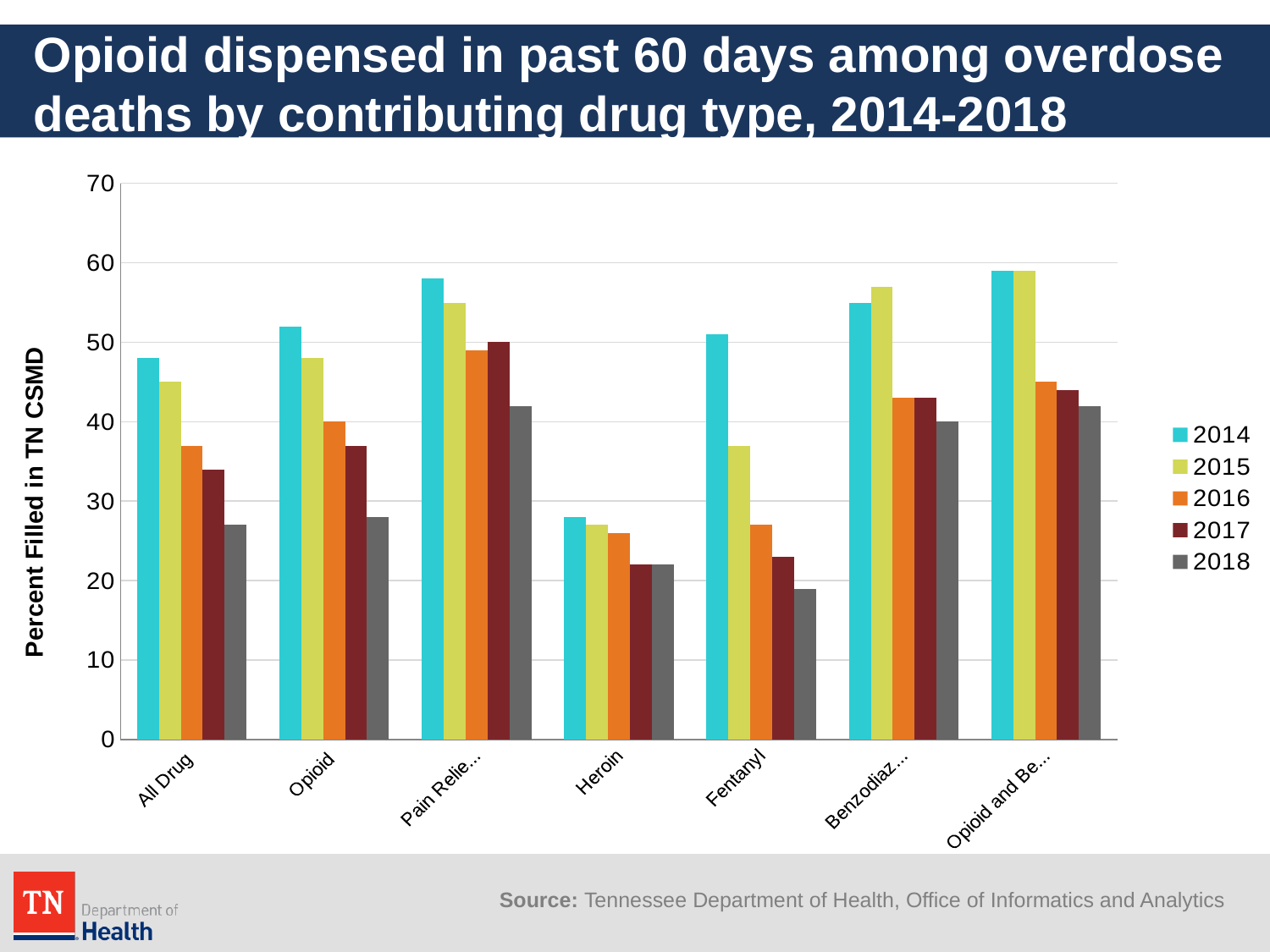
What kind of chart is shown on the slide? bar chart Is the 2016 value for Fentanyl greater or less than 30? less Which year does the legend show in the darkest grey colour? 2018 Is the 2014 value for All Drug greater or less than 40? greater Which category has the lowest 2014 value? Heroin What is the title of the y axis? Percent Filled in TN CSMD For All Drug, do the values rise or fall from 2014 to 2018? fall How many drug-type categories are shown on the x axis? 7 For Fentanyl, which year has the highest value? 2014 Is the 2018 value for Opioid greater or less than 30? less Which is larger, the 2014 value for All Drug or the 2014 value for Heroin? All Drug How many series does the legend list? 5